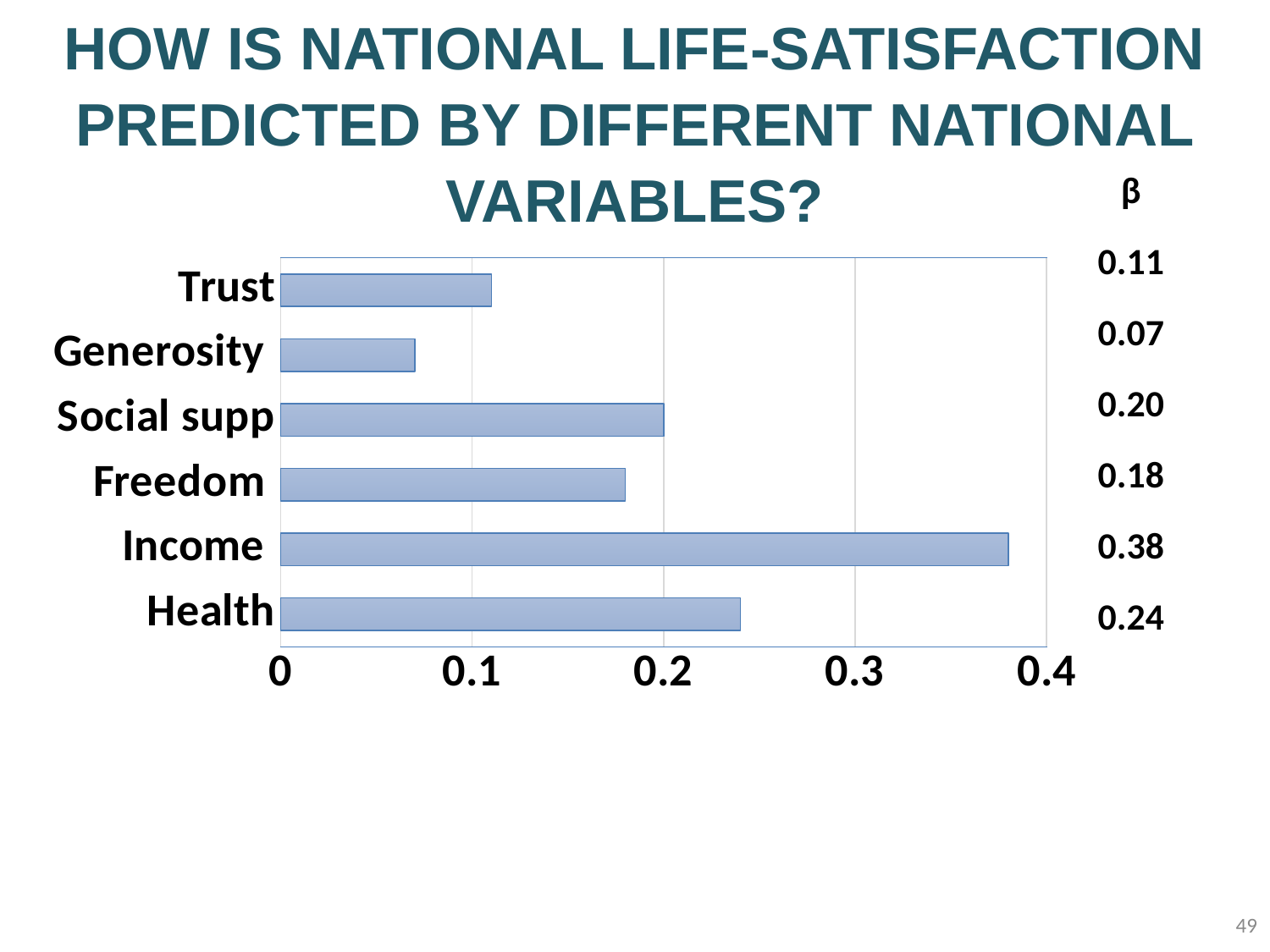
What is the β value for Generosity? 0.07 Which variable has the lowest β value? Generosity Which has a larger β value, Health or Freedom? Health What kind of chart is shown on the slide? bar chart What is the difference between the β values for Income and Health? 0.14 What is the β value for Income? 0.38 What is the β value for Social supp? 0.20 What is the highest value shown on the horizontal axis? 0.4 Is the value for Trust greater or less than 0.1? greater How many variables are shown in the chart? 6 What is the difference between the β values for Social supp and Freedom? 0.02 Which variable has the highest β value? Income